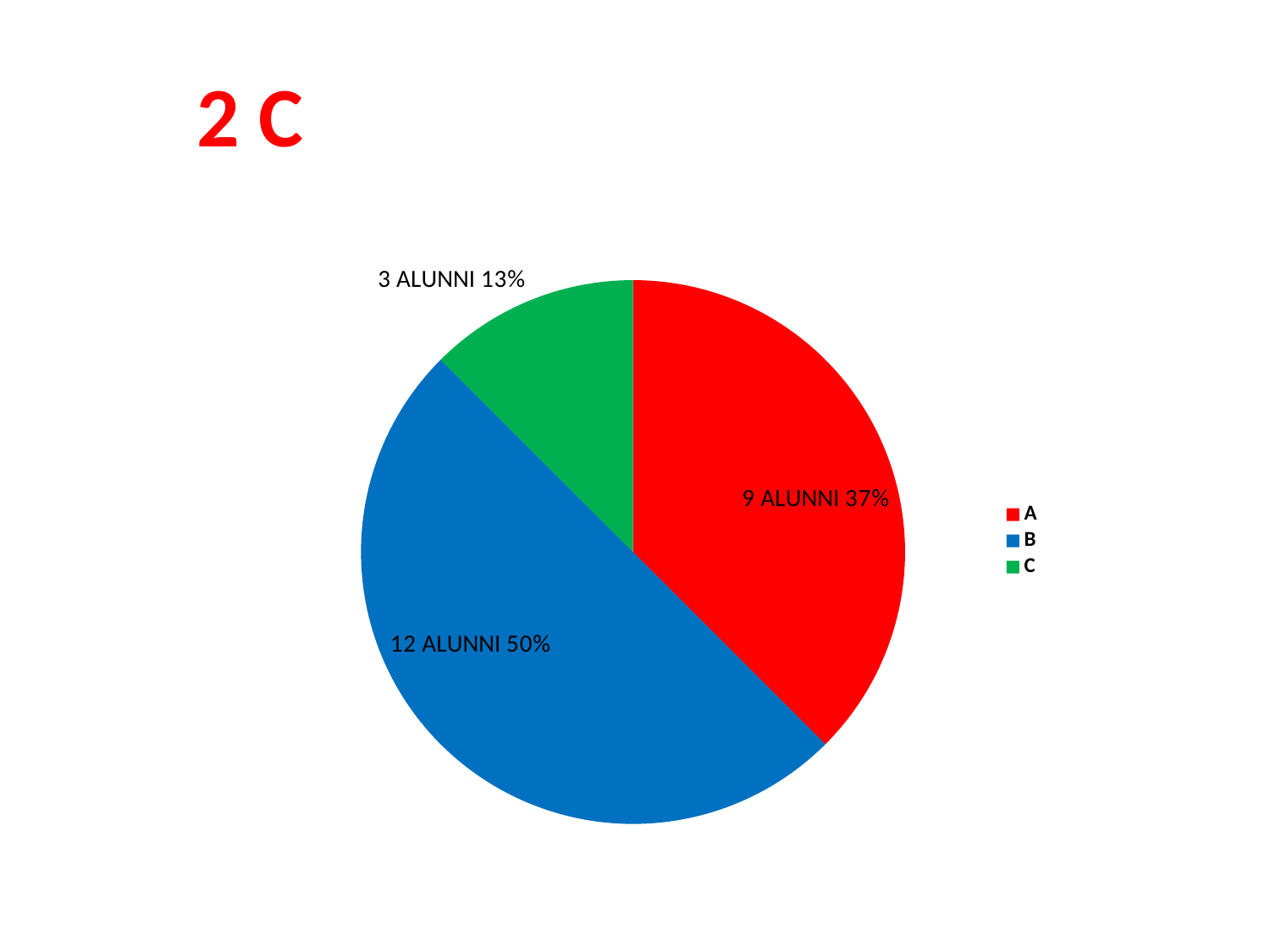
Which is larger, the slice for A or the slice for C? A What colour is the slice for category B? blue What percentage share does slice A have? 37% How many slices does the pie chart have? 3 How many alunni are in category C? 3 ALUNNI What percentage share does slice C have? 13% What kind of chart is shown on the slide? pie chart Which category has the smallest slice? C How many alunni are in category B? 12 ALUNNI Which category has the largest slice? B How many entries does the legend list? 3 What percentage share does slice B have? 50%